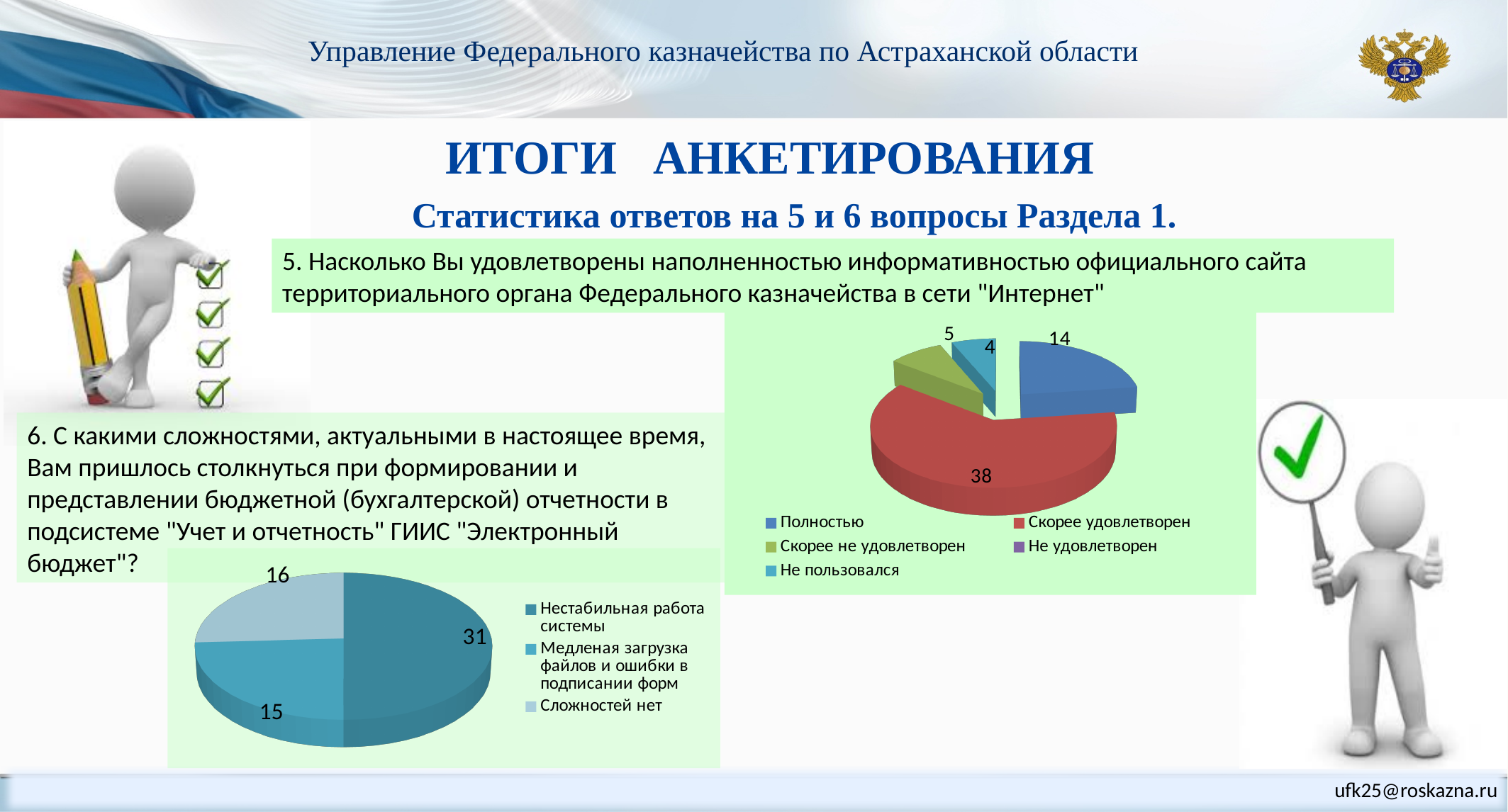
In the pie chart on the right (question 5), which category has the largest slice? Скорее удовлетворен What type of chart is used for question 6 at the bottom left of the slide? Pie chart In the pie chart on the right (question 5), which is larger: "Скорее не удовлетворен" or "Не пользовался"? Скорее не удовлетворен How many entries does the legend of the pie chart on the right (question 5) list? 5 In the pie chart on the right (question 5), what is the difference between "Скорее удовлетворен" and "Полностью"? 24 In the pie chart on the right (question 5), what is the value for "Полностью"? 14 In the pie chart on the right (question 5), what is the value for "Не пользовался"? 4 In the pie chart on the right (question 5), how many respondents answered "Скорее удовлетворен"? 38 In the pie chart at the bottom left (question 6), which category has the smallest slice? Медленая загрузка файлов и ошибки в подписании форм In the pie chart at the bottom left (question 6), what is the total of all slices? 62 In the pie chart at the bottom left (question 6), what share of the total does "Нестабильная работа системы" represent? 50% In the pie chart at the bottom left (question 6), what is the value for "Нестабильная работа системы"? 31